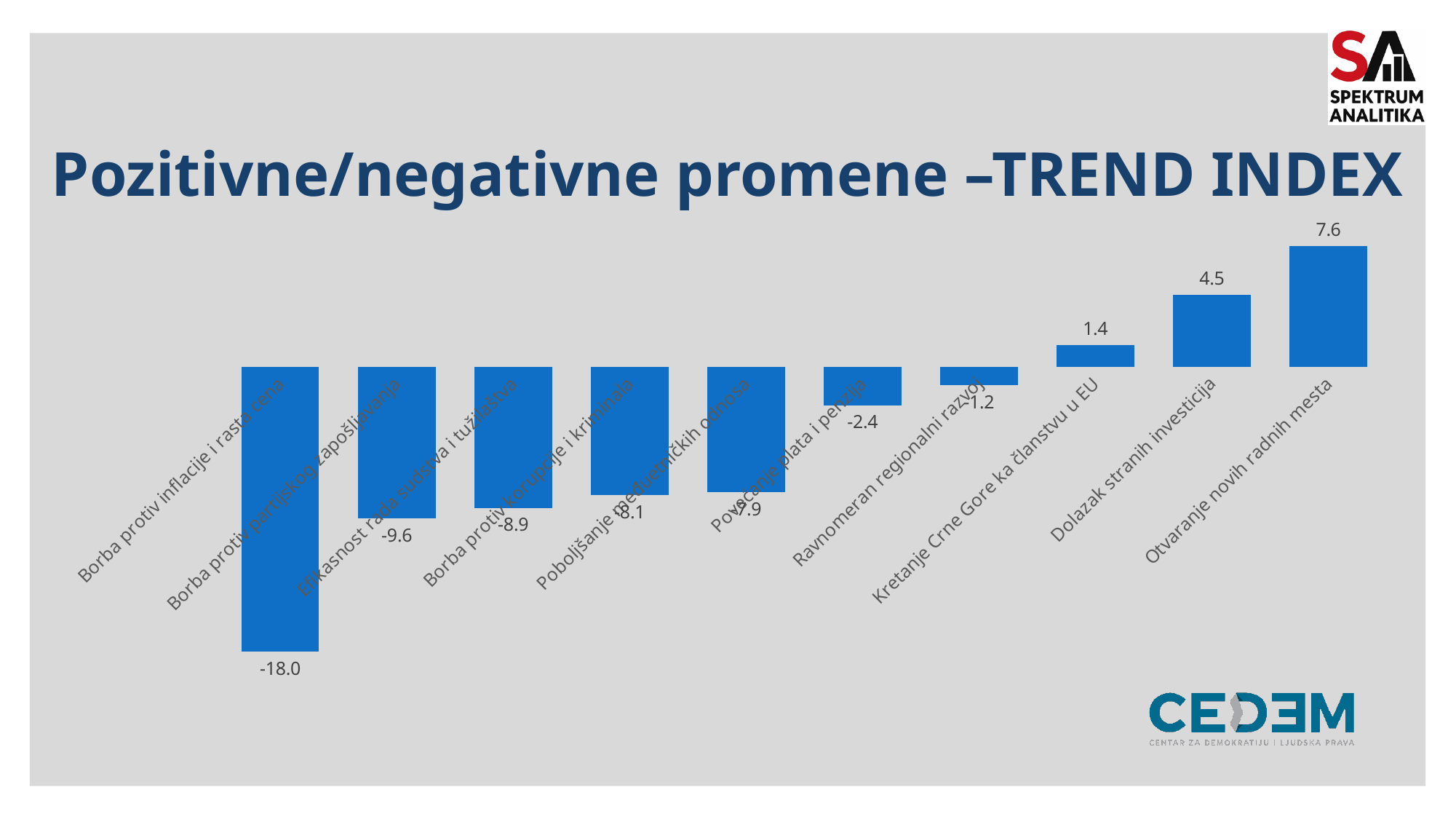
What is the title of the chart? Pozitivne/negativne promene –TREND INDEX Which category has the lowest value? Borba protiv inflacije i rasta cena Which category has the highest value? Otvaranje novih radnih mesta Do the values rise or fall moving from left to right along the x axis? Rise What is the value for 'Borba protiv inflacije i rasta cena'? -18.0 How many categories are plotted in the chart? 10 What is the value for 'Dolazak stranih investicija'? 4.5 What is the difference between the values for 'Otvaranje novih radnih mesta' and 'Dolazak stranih investicija'? 3.1 What is the value for 'Otvaranje novih radnih mesta'? 7.6 What is the value for 'Kretanje Crne Gore ka članstvu u EU'? 1.4 What type of chart is shown on the slide? Bar chart What is the value for 'Borba protiv partijskog zapošljavanja'? -9.6